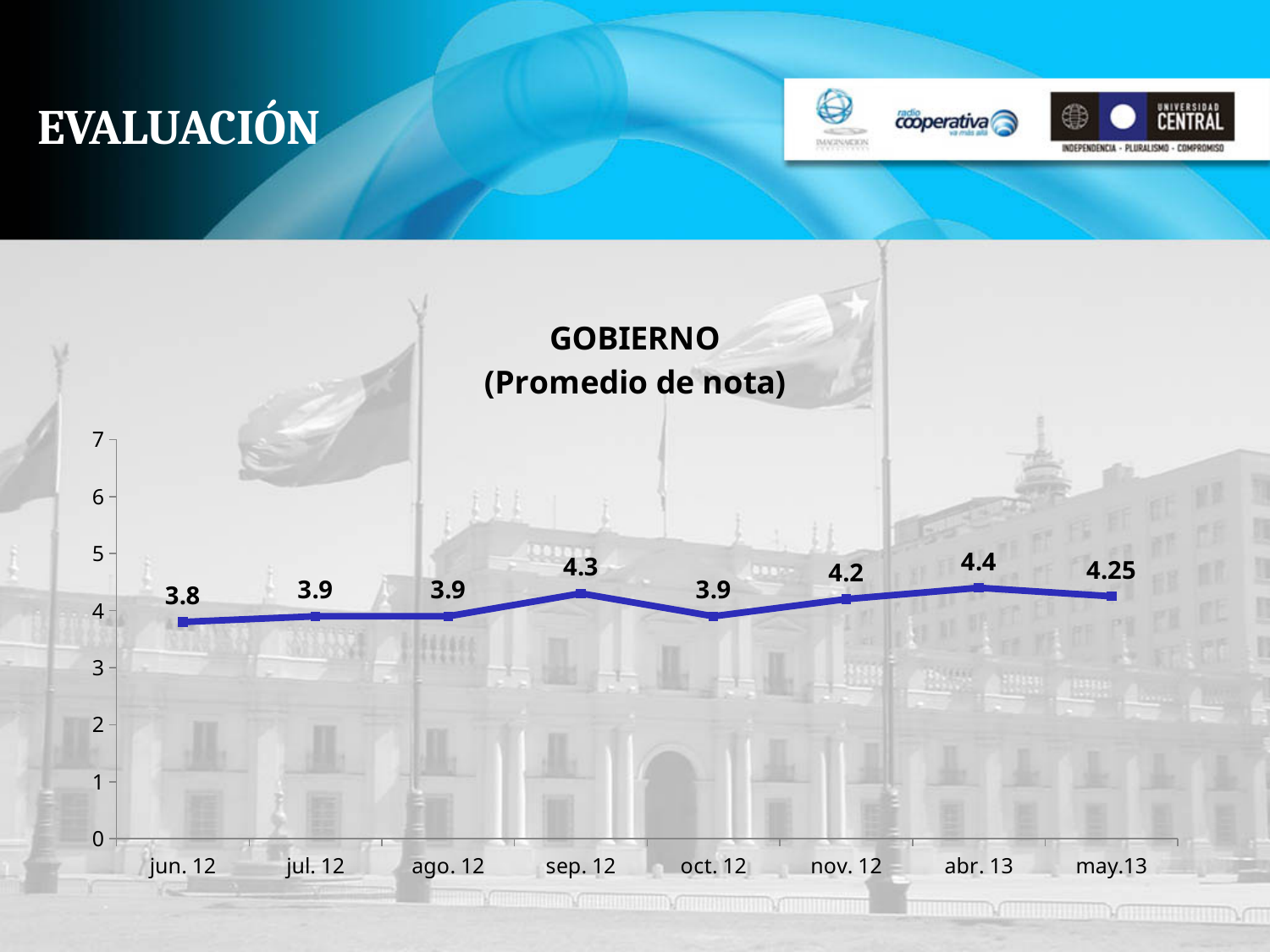
What is the value for may.13? 4.25 Which is larger, the value for sep. 12 or the value for oct. 12? sep. 12 Is the value for nov. 12 greater or less than 5? less Which month has the highest value? abr. 13 What is the value for sep. 12? 4.3 How many data points are plotted on the chart? 8 Which month has the lowest value? jun. 12 What is the difference between the values for abr. 13 and jun. 12? 0.6 What is the value for jun. 12? 3.8 What kind of chart is shown on the slide? line chart Does the value rise or fall from abr. 13 to may.13? fall What is the title of the chart? GOBIERNO (Promedio de nota)